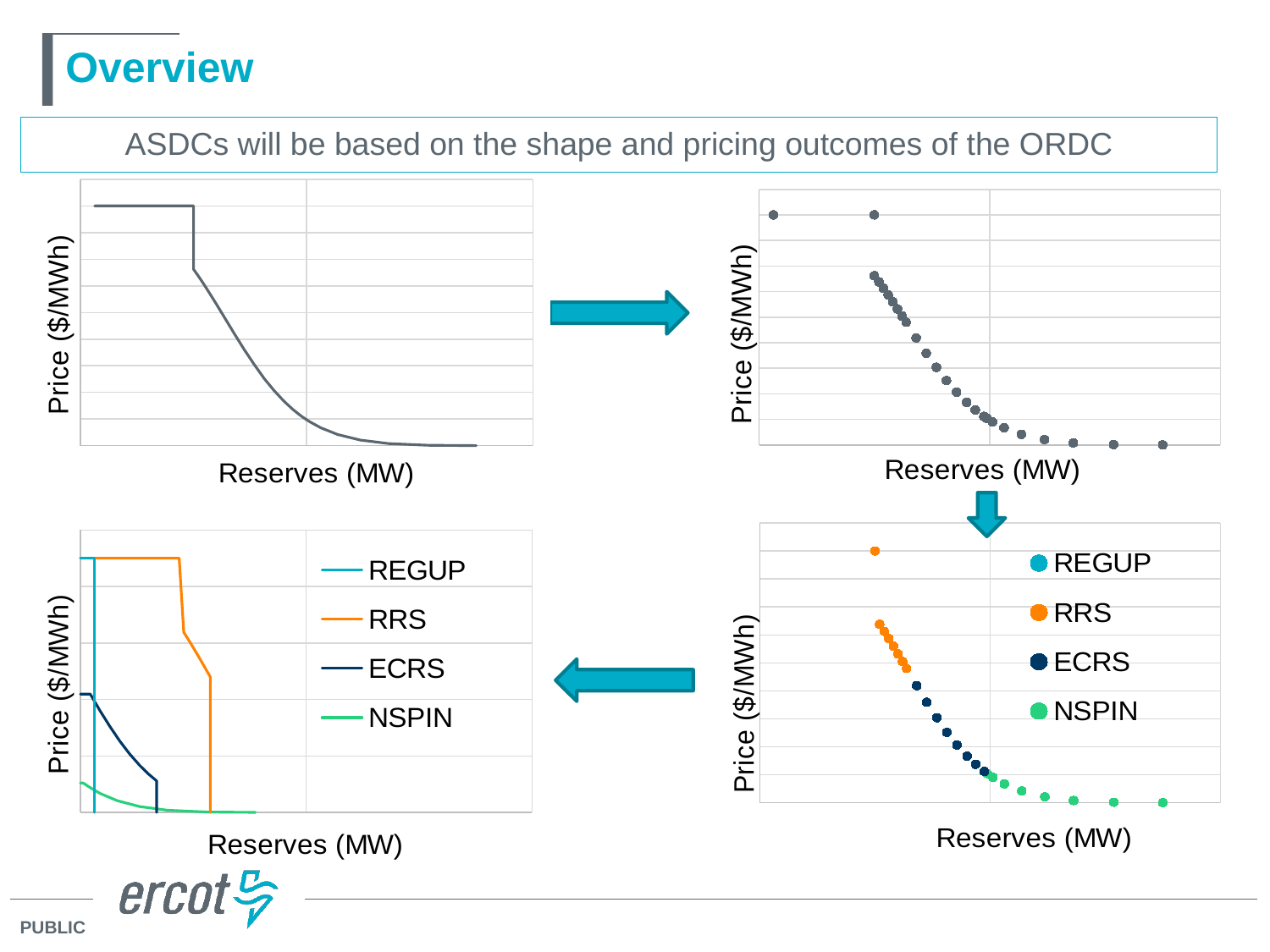
How many series does the legend of the bottom-left chart list? 4 In the bottom-left chart, which series has the lowest prices overall? NSPIN What kind of chart is the top-right chart? scatter chart What is the y-axis title of the bottom-right chart? Price ($/MWh) What kind of chart is the bottom-left chart? line chart In the top-left chart, does the price rise or fall as reserves increase? fall In the top-right chart, does the price rise or fall as reserves increase? fall What kind of chart is the top-left chart? line chart Which series are listed in the legend of the bottom-left chart? REGUP, RRS, ECRS, NSPIN How many series does the legend of the bottom-right chart list? 4